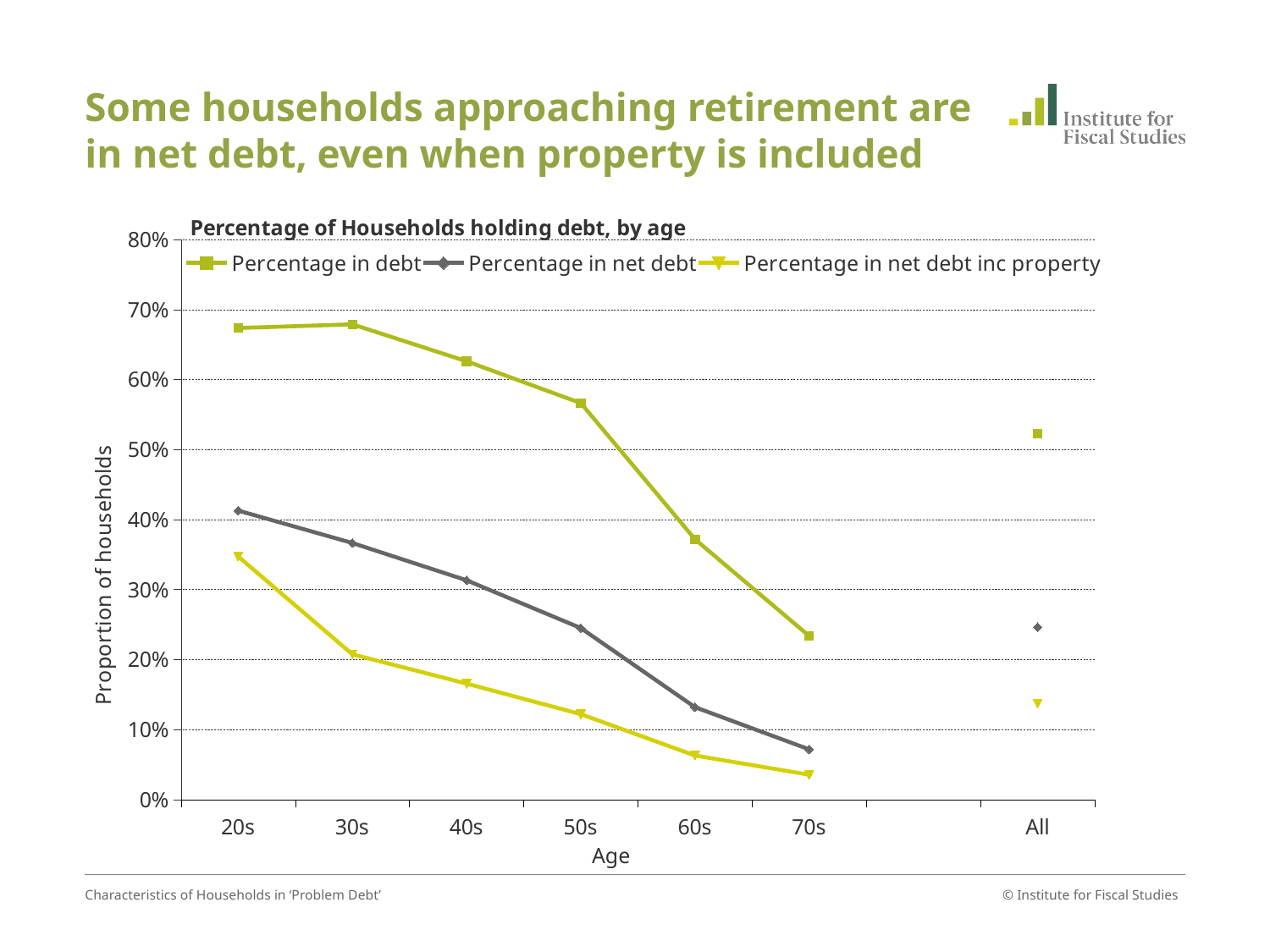
Is the value for Percentage in net debt inc property for the 30s greater or less than 30%? less Is the value for Percentage in debt for the 60s greater or less than 40%? less What kind of chart is shown on the slide? line chart Does the Percentage in net debt rise or fall from the 20s to the 70s? fall How many series does the legend list? 3 How many age categories are shown on the x axis? 7 Is the value for Percentage in debt for the 50s greater or less than 50%? greater For the 20s, which is larger: Percentage in net debt or Percentage in net debt inc property? Percentage in net debt Which age group has the lowest value for Percentage in debt? 70s Which age group has the lowest value for Percentage in net debt inc property? 70s Which age group has the highest value for Percentage in net debt? 20s What is the title of the chart? Percentage of Households holding debt, by age